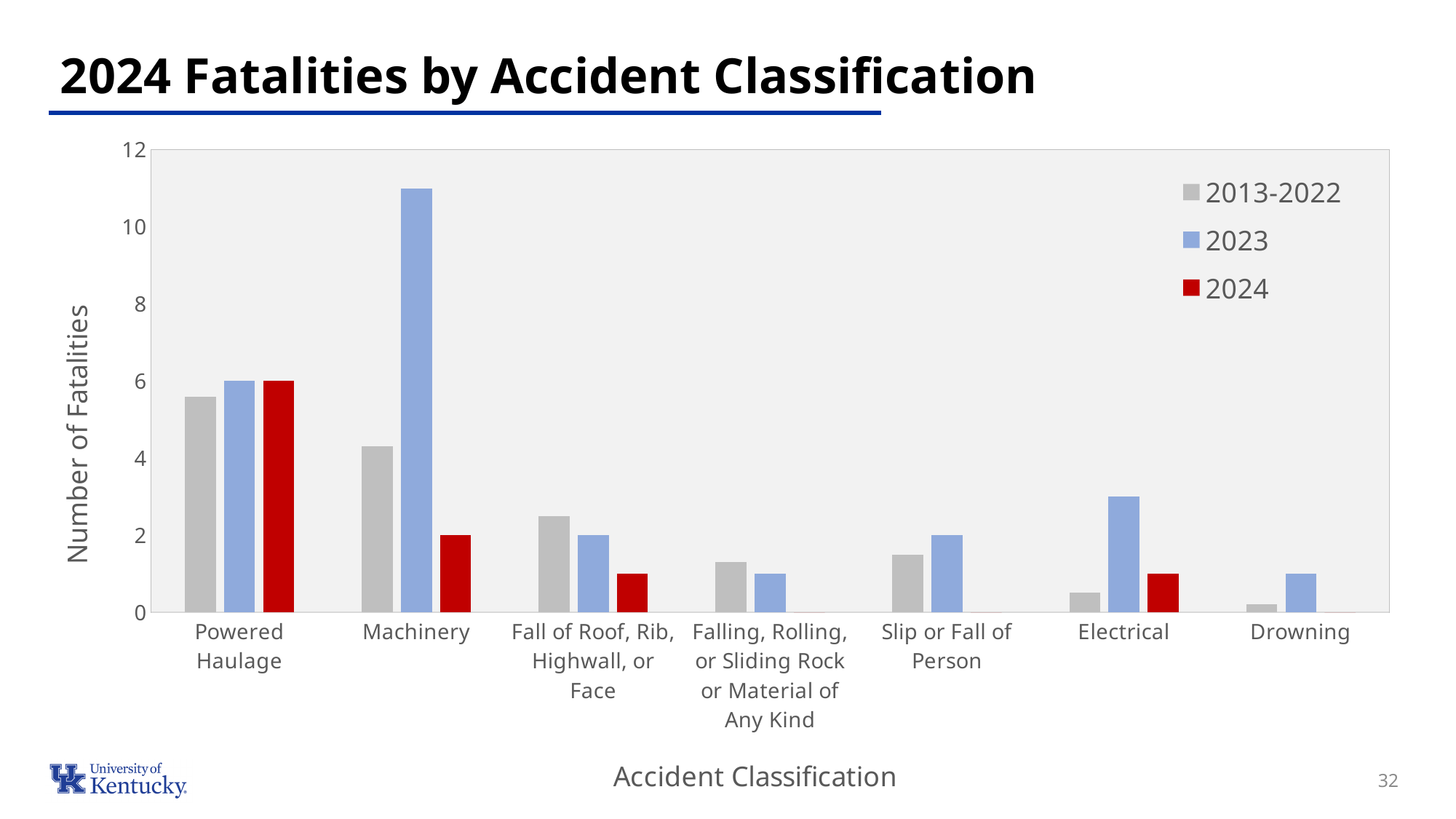
What is the number of fatalities for Slip or Fall of Person in 2023? 2 What is the number of fatalities for Machinery in 2024? 2 How many series does the legend list? 3 What is the number of fatalities for Powered Haulage in 2024? 6 Which accident classification has the lowest value in the 2013-2022 series? Drowning Is the 2023 value for Machinery greater or less than 10? greater Which series is shown in red in the legend? 2024 Which accident classification has the highest value in the 2024 series? Powered Haulage What is the difference between the 2024 values for Powered Haulage and Machinery? 4 Which accident classification has the highest value in the 2023 series? Machinery How many accident classification categories are shown on the x axis? 7 What type of chart is shown on the slide? bar chart